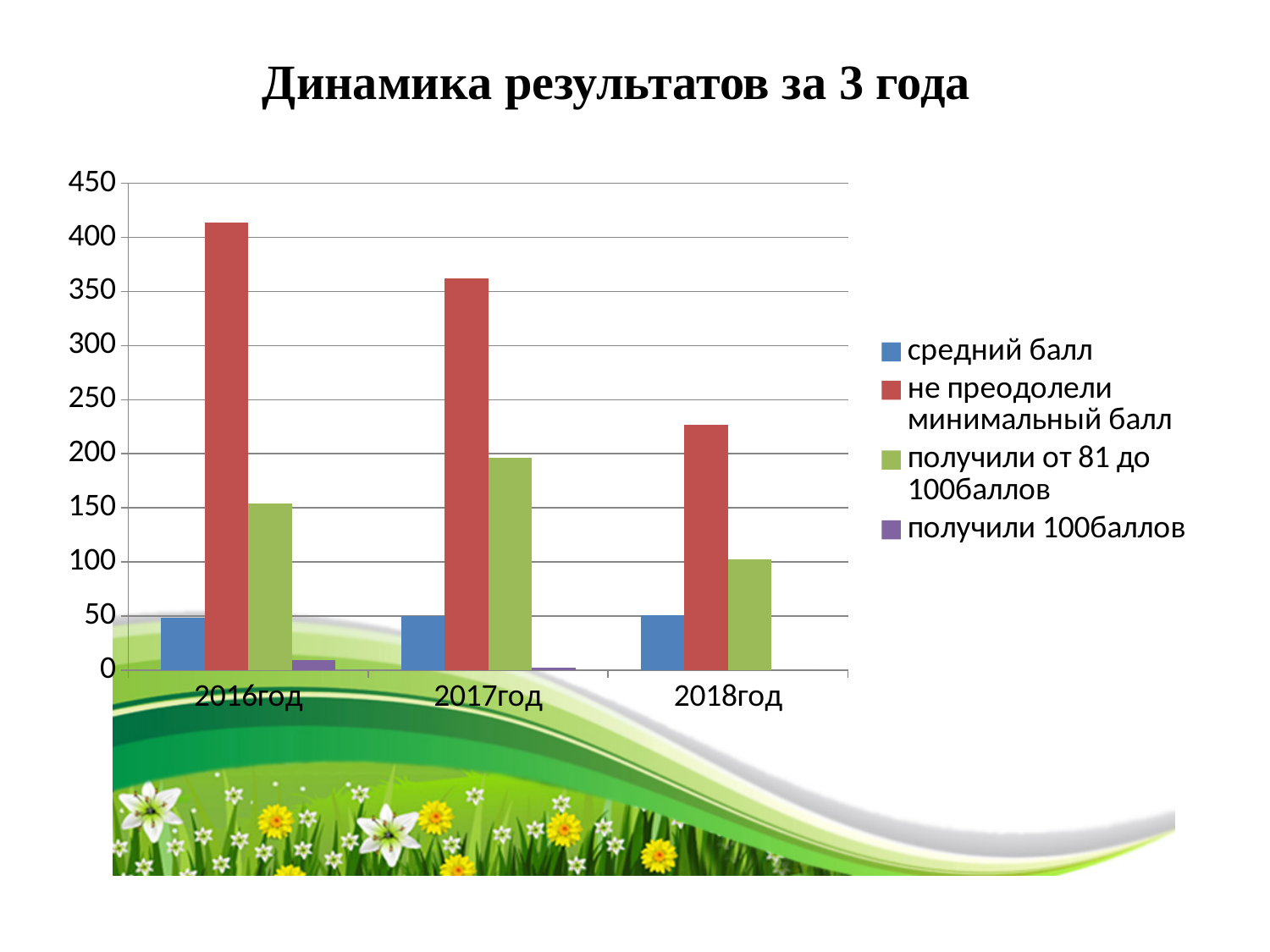
Is the value for 'не преодолели минимальный балл' in 2018год greater or less than 200? greater In which year is the value for 'не преодолели минимальный балл' the highest? 2016год In which year is the value for 'получили от 81 до 100баллов' the highest? 2017год How many series does the legend list? 4 What kind of chart is shown on the slide? bar chart How many year categories are shown on the x axis? 3 In 2017год, which is larger: 'не преодолели минимальный балл' or 'получили от 81 до 100баллов'? не преодолели минимальный балл Is the value for 'получили от 81 до 100баллов' in 2018год greater or less than 150? less What is the title of the slide? Динамика результатов за 3 года Is the value for 'не преодолели минимальный балл' in 2016год greater or less than 400? greater In which year is the value for 'не преодолели минимальный балл' the lowest? 2018год Does the value for 'не преодолели минимальный балл' rise or fall from 2016год to 2018год? fall